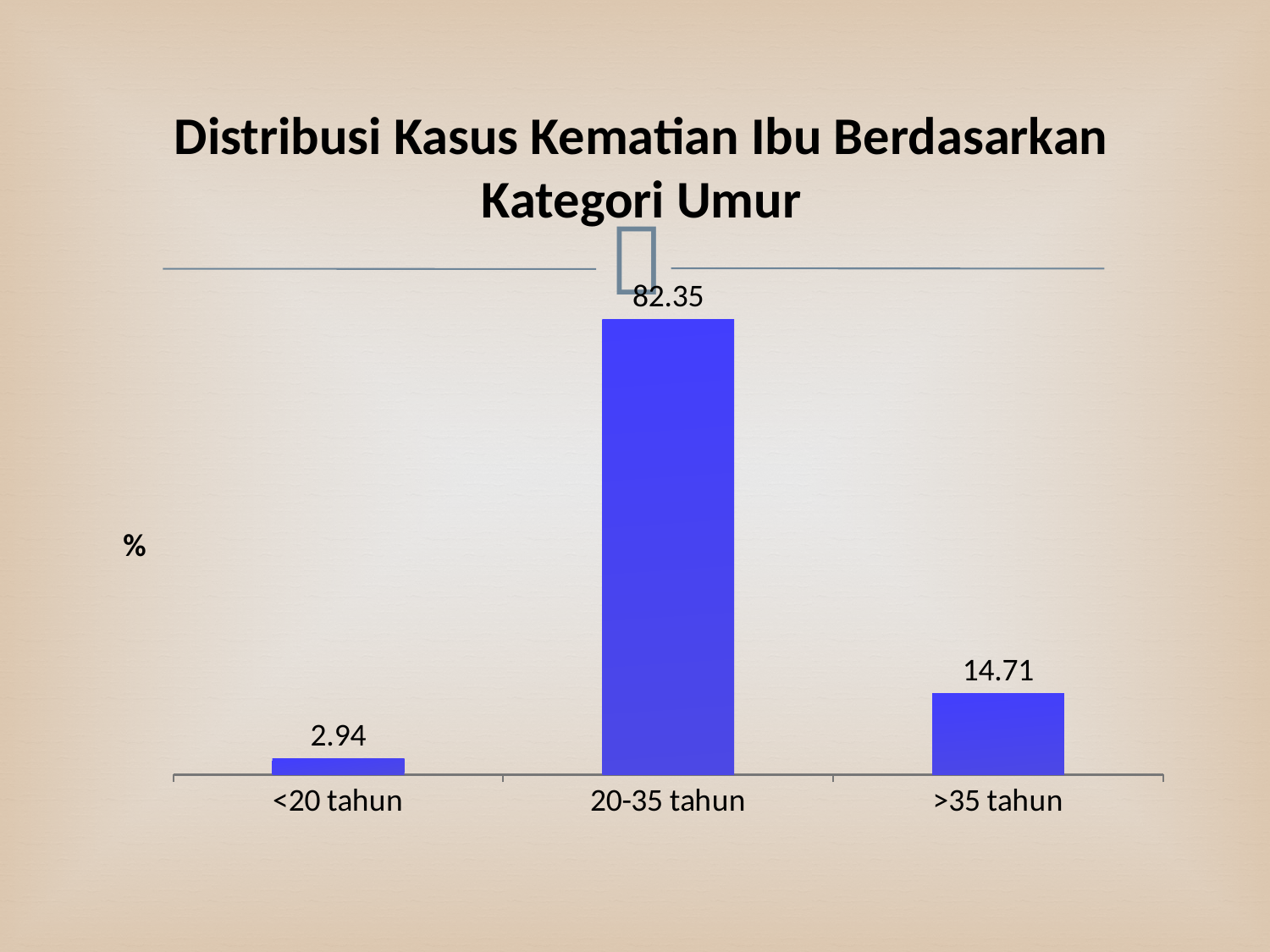
What is the value for the 20-35 tahun category? 82.35 What is the difference between the values for 20-35 tahun and >35 tahun? 67.64 Which age category has the highest value? 20-35 tahun What label is shown on the vertical axis? % What is the difference between the values for >35 tahun and <20 tahun? 11.77 Which age category has the lowest value? <20 tahun What is the value for the <20 tahun category? 2.94 What kind of chart is shown on the slide? Bar chart Which is larger, the value for <20 tahun or the value for >35 tahun? >35 tahun What is the value for the >35 tahun category? 14.71 What is the title of the chart? Distribusi Kasus Kematian Ibu Berdasarkan Kategori Umur How many age categories are shown on the x axis? 3